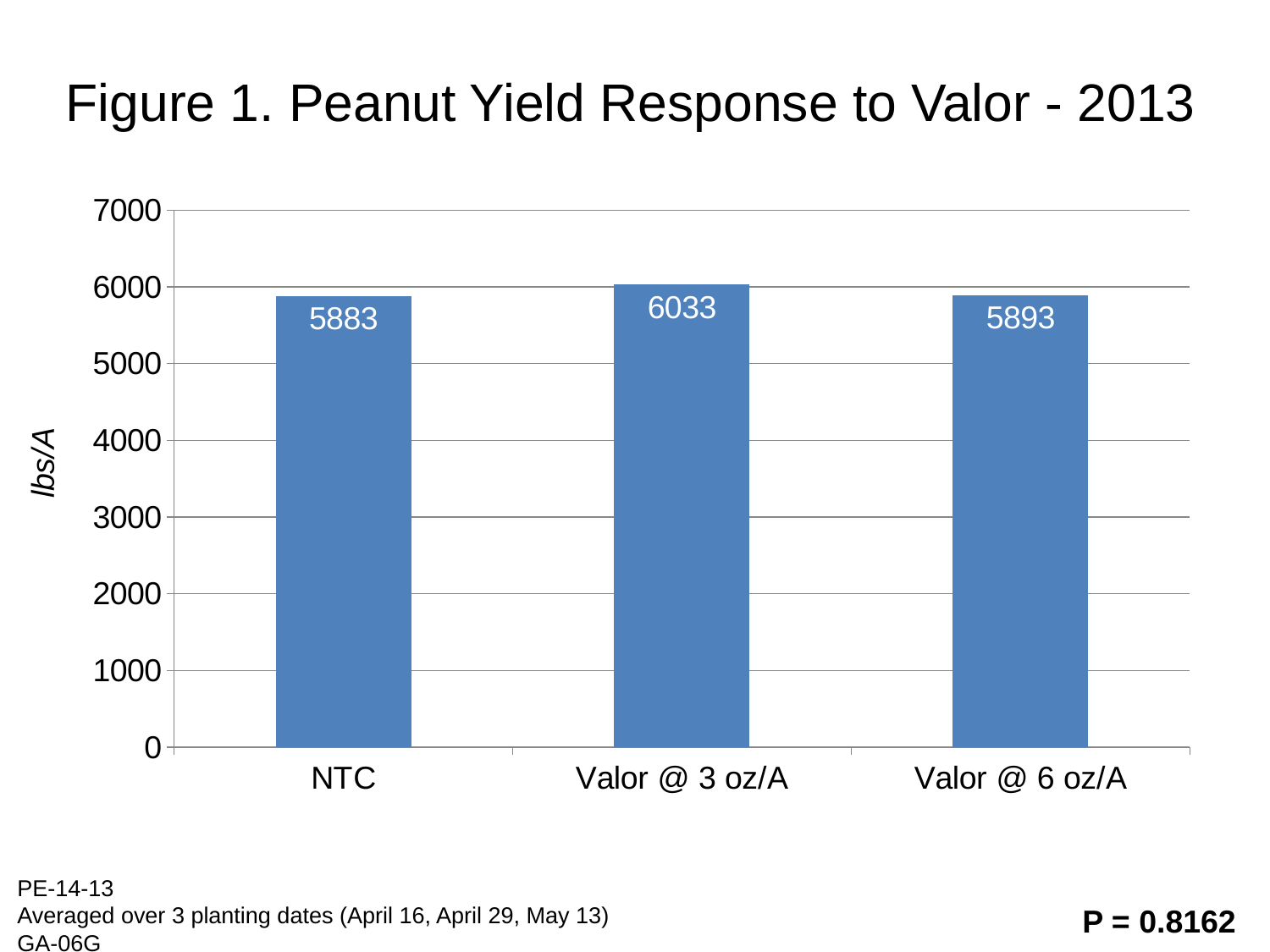
How many treatments are shown on the chart? 3 What is the peanut yield for Valor @ 6 oz/A? 5893 Which treatment has the highest yield? Valor @ 3 oz/A Which treatment has the lowest yield? NTC What is the difference in yield between Valor @ 3 oz/A and NTC? 150 What is the peanut yield for NTC? 5883 What is the difference in yield between Valor @ 6 oz/A and NTC? 10 What kind of chart is shown? Bar chart What is the peanut yield for Valor @ 3 oz/A? 6033 Is the yield for Valor @ 3 oz/A greater or less than 6000? greater Which has a higher yield, Valor @ 3 oz/A or Valor @ 6 oz/A? Valor @ 3 oz/A What is the label on the y axis? lbs/A